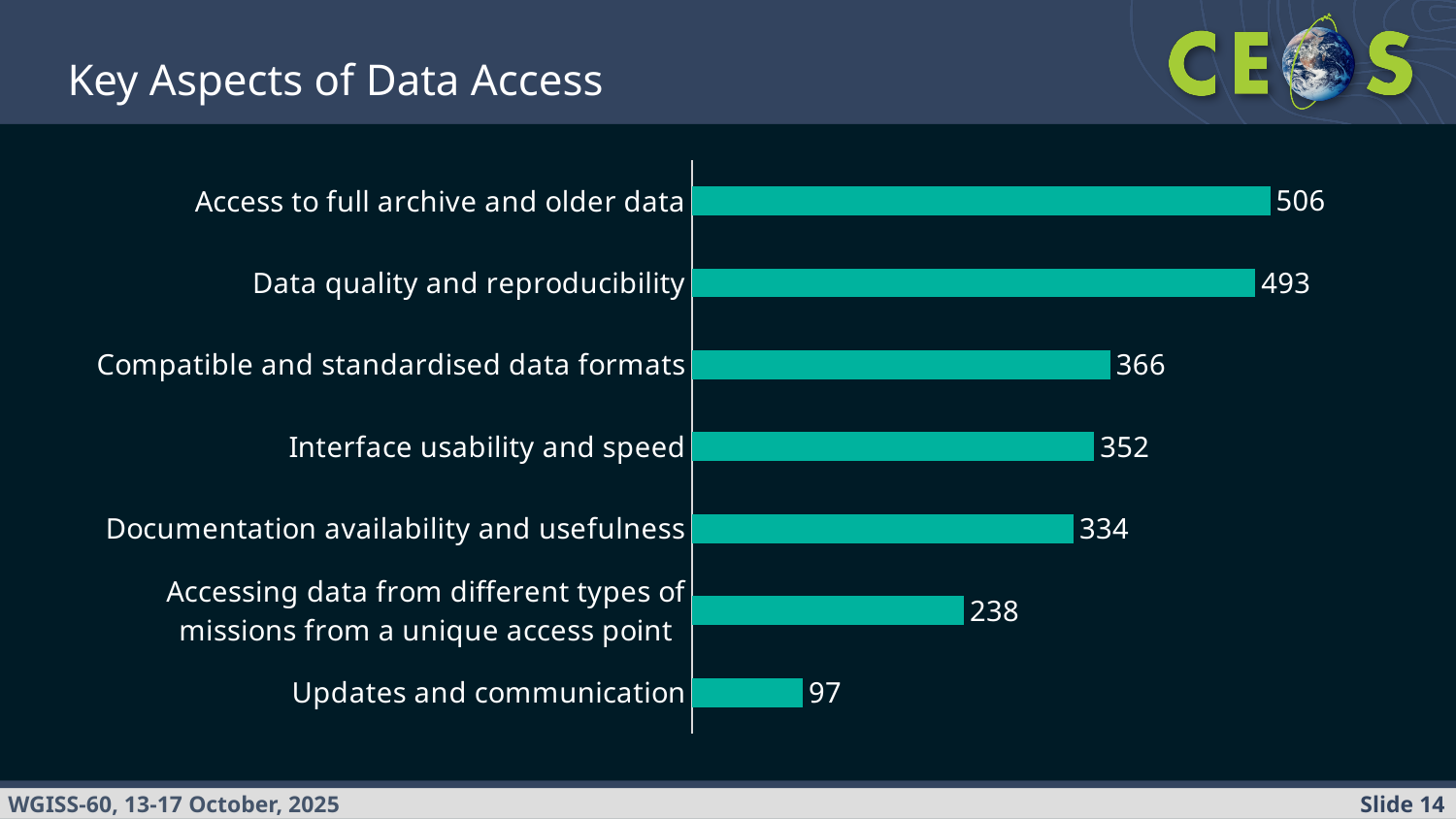
Which is larger: the value for Documentation availability and usefulness or the value for Accessing data from different types of missions from a unique access point? Documentation availability and usefulness Which category has the lowest value? Updates and communication What is the value for Updates and communication? 97 What is the difference between the values for Access to full archive and older data and Data quality and reproducibility? 13 What kind of chart is shown on the slide? Bar chart What is the difference between the values for Compatible and standardised data formats and Updates and communication? 269 What is the value for Data quality and reproducibility? 493 Which category has the highest value? Access to full archive and older data What is the value for Interface usability and speed? 352 How many categories are shown in the chart? 7 What is the title of the slide containing the chart? Key Aspects of Data Access What is the value for Access to full archive and older data? 506